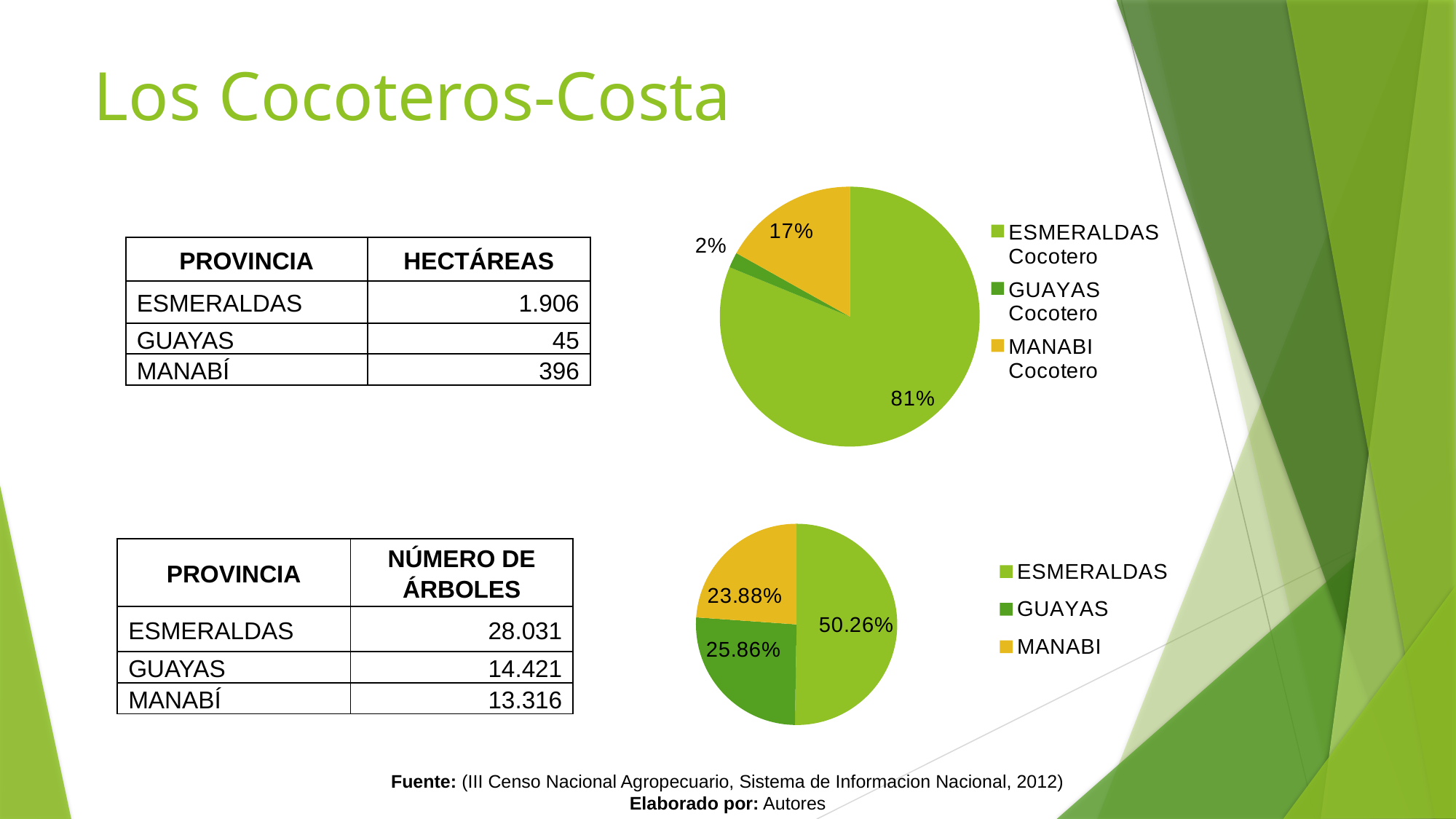
In the bottom pie chart, what share is shown for ESMERALDAS? 50.26% What kind of chart is the top chart on the slide? Pie chart In the top pie chart, which category has the smallest slice? GUAYAS Cocotero In the top pie chart, what share is shown for GUAYAS Cocotero? 2% In the bottom pie chart, what share is shown for GUAYAS? 25.86% In the bottom pie chart, which category has the largest slice? ESMERALDAS In the bottom pie chart, what is the difference in percentage points between the GUAYAS and MANABI slices? 1.98 How many categories does the legend of the bottom pie chart list? 3 In the top pie chart, which category has the largest slice? ESMERALDAS Cocotero